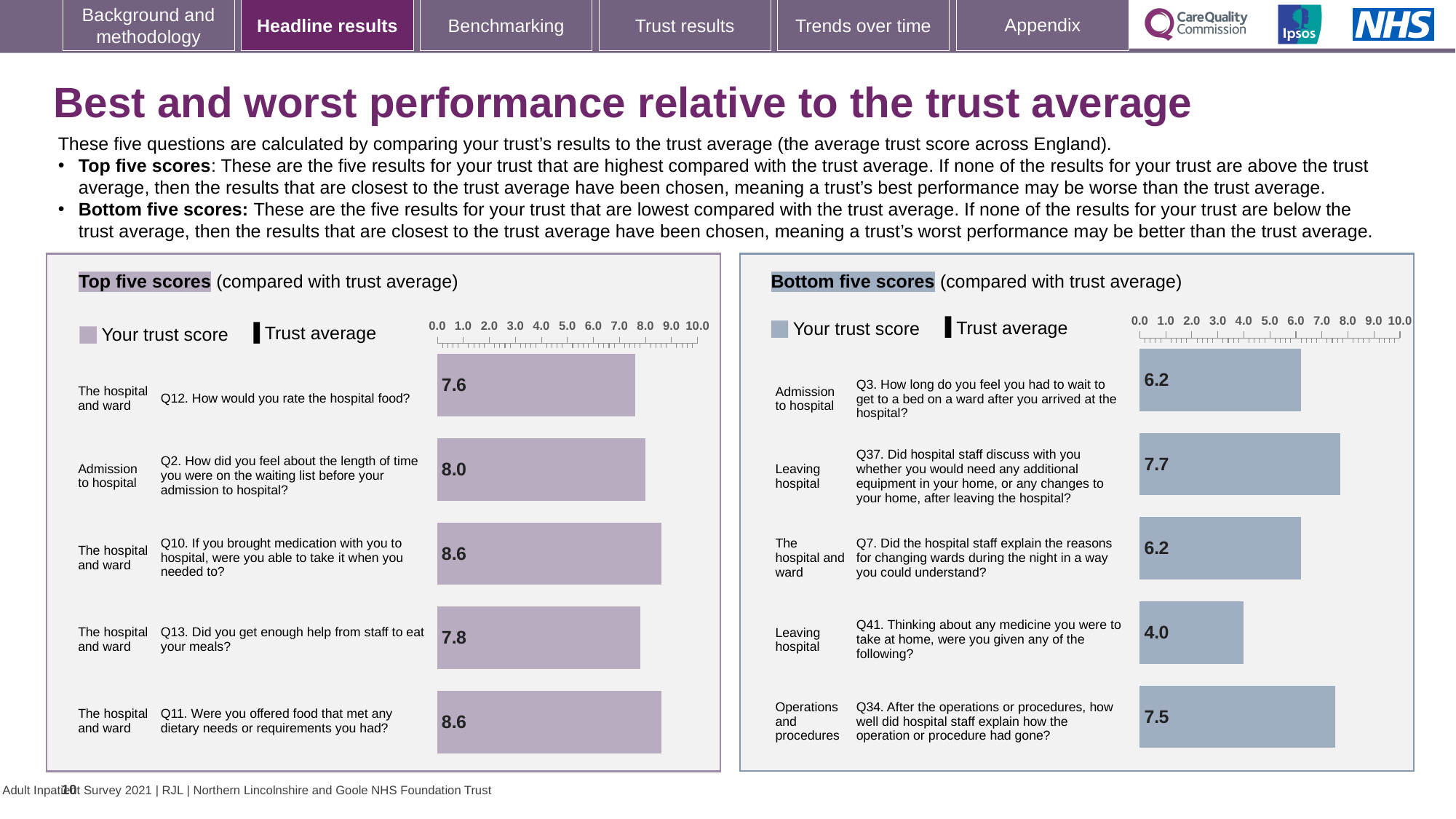
What type of chart is used in the Top five scores panel? Bar chart In the Top five scores chart, what is the trust score for Q2 about the length of time on the waiting list before admission? 8.0 How many questions are shown in the Bottom five scores chart? 5 In the Top five scores chart, what is the difference between the score for Q10 and the score for Q13? 0.8 In the Bottom five scores chart, which question has the lowest trust score? Q41 In the Bottom five scores chart, what is the trust score for Q37 about discussing additional equipment or changes to your home? 7.7 In the Bottom five scores chart, which question has the highest trust score? Q37 In the Bottom five scores chart, what is the difference between the score for Q34 and the score for Q41? 3.5 In the Top five scores chart, what is the trust score for Q12 (How would you rate the hospital food?)? 7.6 In the Top five scores chart, which has the higher score: Q2 or Q13? Q2 In the Bottom five scores chart, what is the trust score for Q41 about medicine to take at home? 4.0 In the Top five scores chart, which question has the lowest trust score? Q12